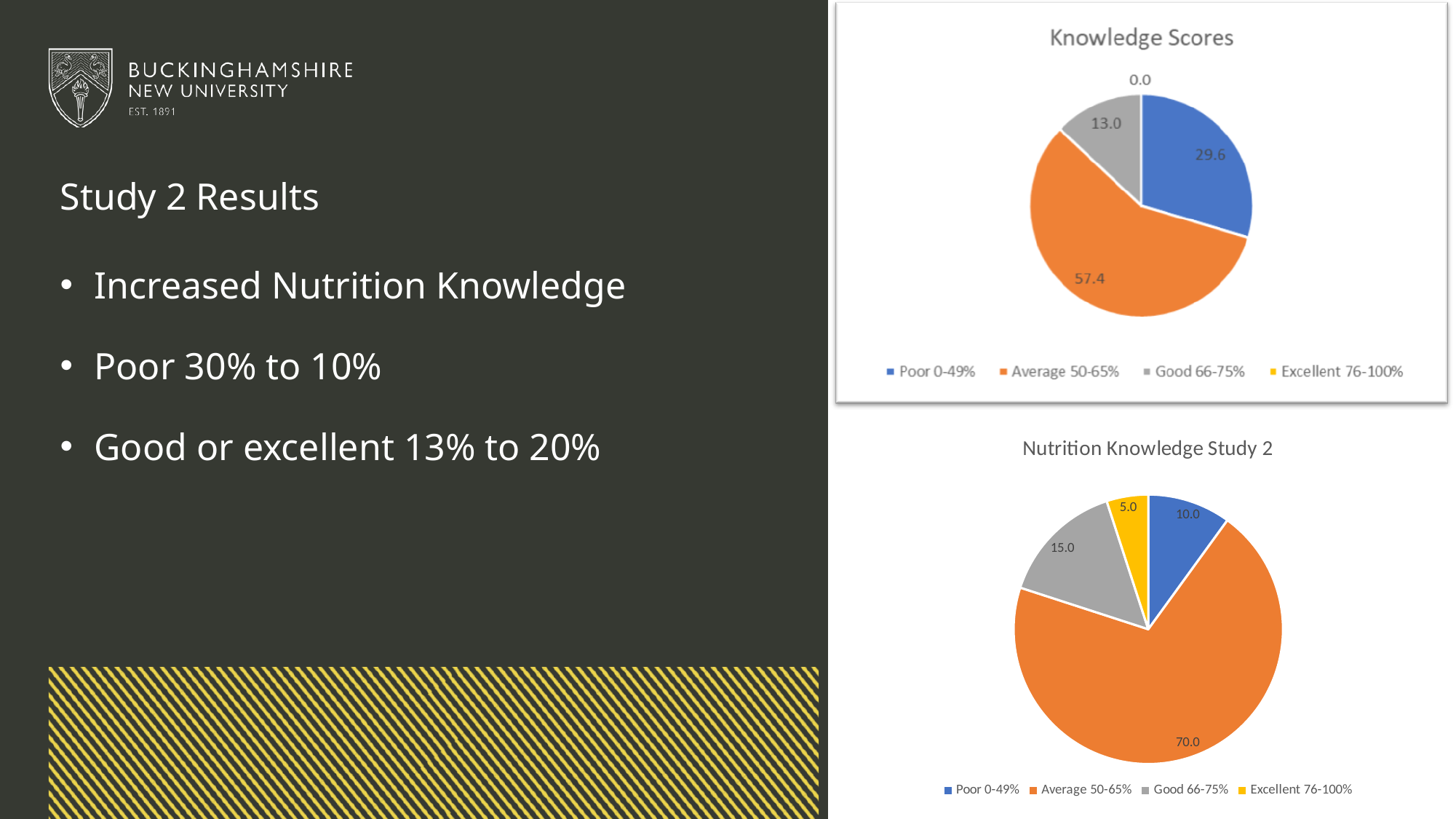
In the 'Knowledge Scores' chart, what is the value for Average 50-65%? 57.4 How many categories does the legend of the 'Knowledge Scores' chart list? 4 In the 'Knowledge Scores' chart, what is the value for Poor 0-49%? 29.6 In the 'Knowledge Scores' chart, which category has the largest slice? Average 50-65% In the 'Nutrition Knowledge Study 2' chart, what is the difference between the Average 50-65% and Poor 0-49% values? 60.0 In the 'Nutrition Knowledge Study 2' chart, what is the value for Excellent 76-100%? 5.0 In the 'Nutrition Knowledge Study 2' chart, which is larger: Poor 0-49% or Good 66-75%? Good 66-75% In the 'Nutrition Knowledge Study 2' chart, which category has the smallest slice? Excellent 76-100% In the 'Nutrition Knowledge Study 2' chart, what is the value for Good 66-75%? 15.0 In the 'Knowledge Scores' chart, what is the value for Excellent 76-100%? 0.0 In the 'Knowledge Scores' chart, what is the difference between the Poor 0-49% and Good 66-75% values? 16.6 What type of chart is the 'Nutrition Knowledge Study 2' chart? Pie chart